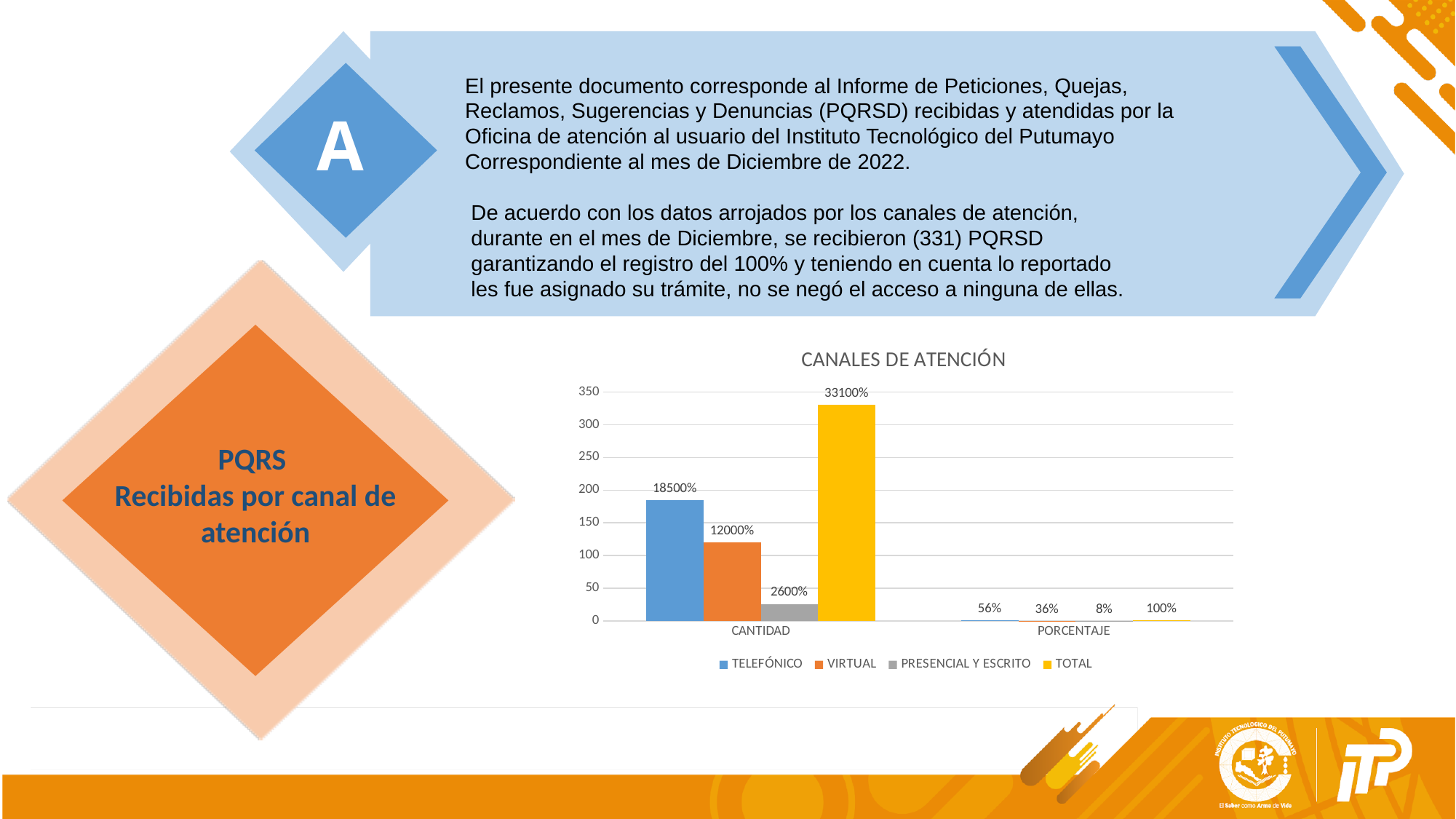
What is the data label for VIRTUAL in the CANTIDAD category? 12000% How many categories are shown on the x axis of the chart? 2 What is the title of the chart? CANALES DE ATENCIÓN Which is larger in the CANTIDAD category, TELEFÓNICO or VIRTUAL? TELEFÓNICO What is the data label for TOTAL in the CANTIDAD category? 33100% How many series does the chart legend list? 4 Which series has the lowest value in the CANTIDAD category? PRESENCIAL Y ESCRITO What is the data label for TELEFÓNICO in the CANTIDAD category? 18500% What type of chart is shown on the slide? bar chart What is the data label for PRESENCIAL Y ESCRITO in the PORCENTAJE category? 8% What is the data label for TELEFÓNICO in the PORCENTAJE category? 56% What is the data label for PRESENCIAL Y ESCRITO in the CANTIDAD category? 2600%